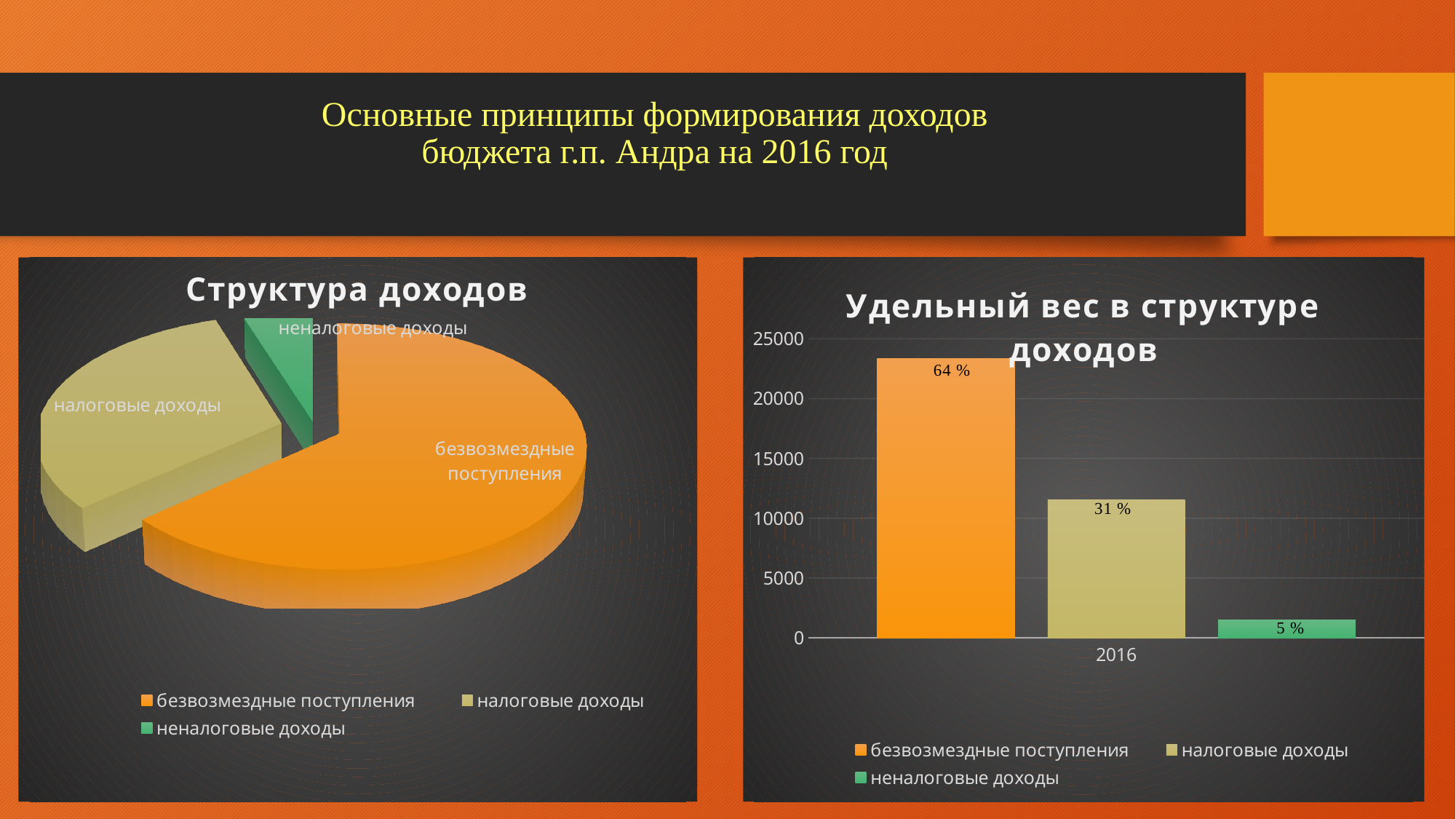
In the pie chart "Структура доходов", which slice is the largest? безвозмездные поступления In the bar chart "Удельный вес в структуре доходов", what label is printed on the bar for безвозмездные поступления? 64 % In the pie chart "Структура доходов", which slice is the smallest? неналоговые доходы In the bar chart "Удельный вес в структуре доходов", which is larger: the bar for налоговые доходы or the bar for неналоговые доходы? налоговые доходы In the bar chart "Удельный вес в структуре доходов", what label is printed on the bar for налоговые доходы? 31 % In the bar chart "Удельный вес в структуре доходов", how many series does the legend list? 3 In the bar chart "Удельный вес в структуре доходов", is the bar for безвозмездные поступления greater or less than 20000? greater What kind of chart is the right chart titled "Удельный вес в структуре доходов"? bar chart In the bar chart "Удельный вес в структуре доходов", is the bar for неналоговые доходы greater or less than 5000? less What kind of chart is the left chart titled "Структура доходов"? pie chart In the bar chart "Удельный вес в структуре доходов", what label is printed on the bar for неналоговые доходы? 5 % In the pie chart "Структура доходов", how many slices are there? 3